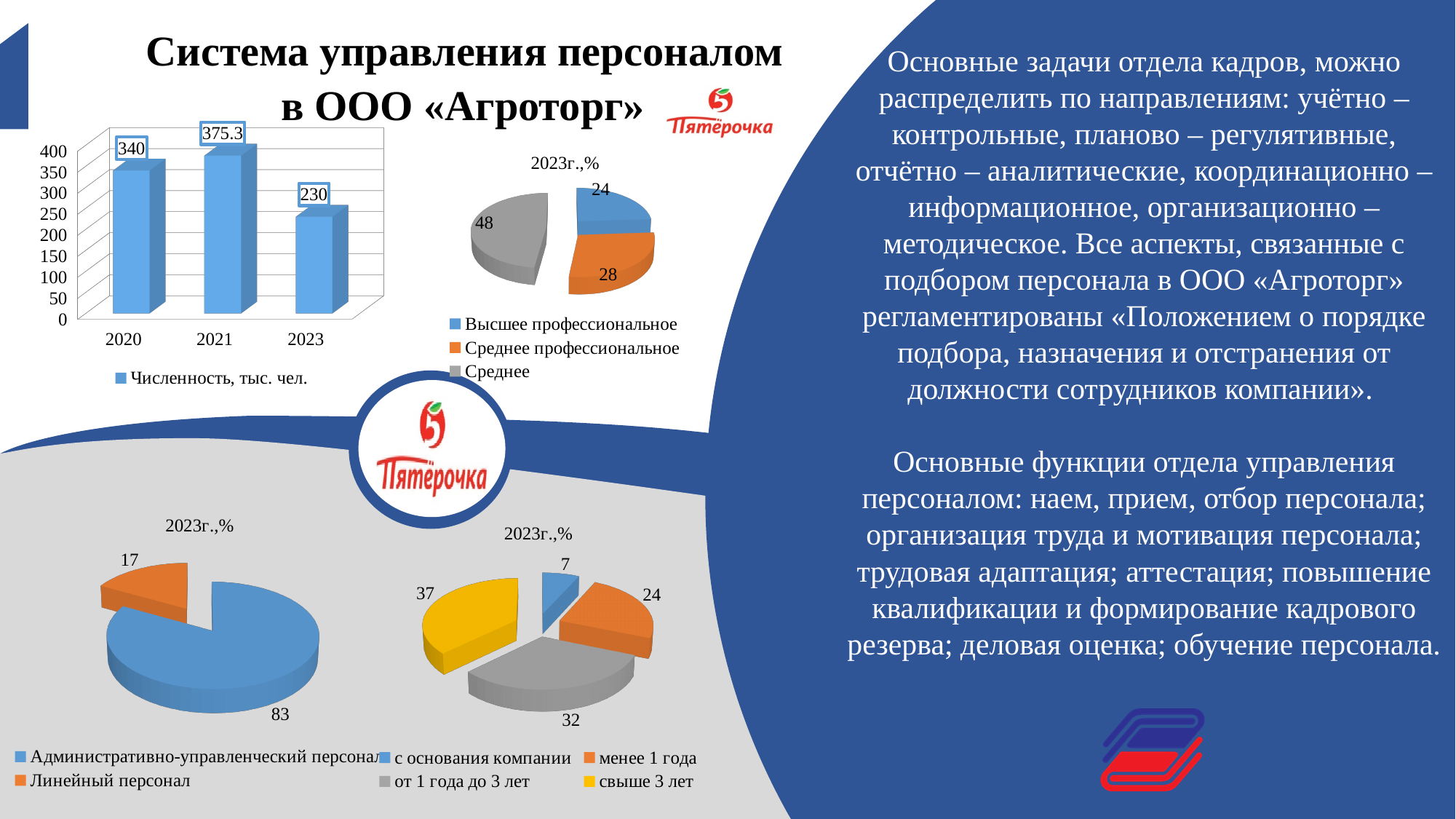
In the bar chart at the top left, what series name does the legend show? Численность, тыс. чел. What type of chart is the chart at the top left of the slide? Bar chart In the bar chart at the top left, which year has the lowest value? 2023 In the pie chart at the top right, how many categories does the legend list? 3 In the pie chart at the top right, what is the value for Среднее профессиональное? 28 In the bar chart at the top left, what is the value for 2021? 375.3 In the pie chart at the bottom right, which category has the smallest slice? с основания компании In the pie chart at the bottom right, which is larger: от 1 года до 3 лет or менее 1 года? от 1 года до 3 лет In the pie chart at the top right, which category has the largest slice? Среднее In the bar chart at the top left, how many years are shown on the x axis? 3 In the bar chart at the top left, what is the difference between the values for 2020 and 2023? 110 In the pie chart at the bottom left, what is the value for Линейный персонал? 17